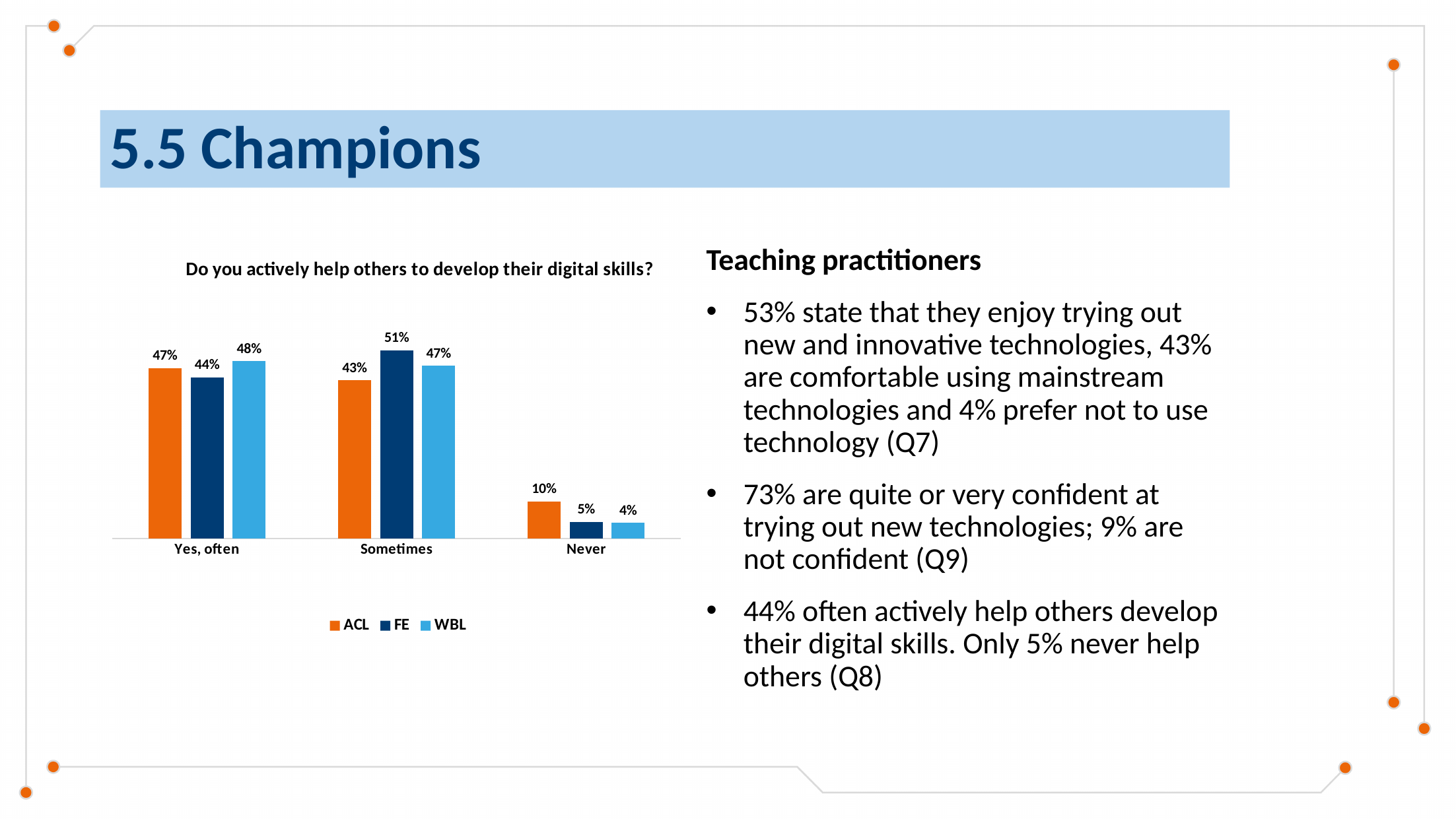
How many categories are shown on the x axis? 3 Which series is shown in orange in the legend? ACL How many series does the legend list? 3 Which series has the highest value in the 'Sometimes' category? FE Which series has the lowest value in the 'Never' category? WBL What is the value for WBL in the 'Yes, often' category? 48% What is the difference between the ACL and FE values in the 'Never' category? 5% What is the value for ACL in the 'Never' category? 10% What kind of chart is shown on the slide? Bar chart Which is larger: the FE value for 'Yes, often' or the FE value for 'Sometimes'? Sometimes What is the value for FE in the 'Sometimes' category? 51% What is the title of the chart? Do you actively help others to develop their digital skills?